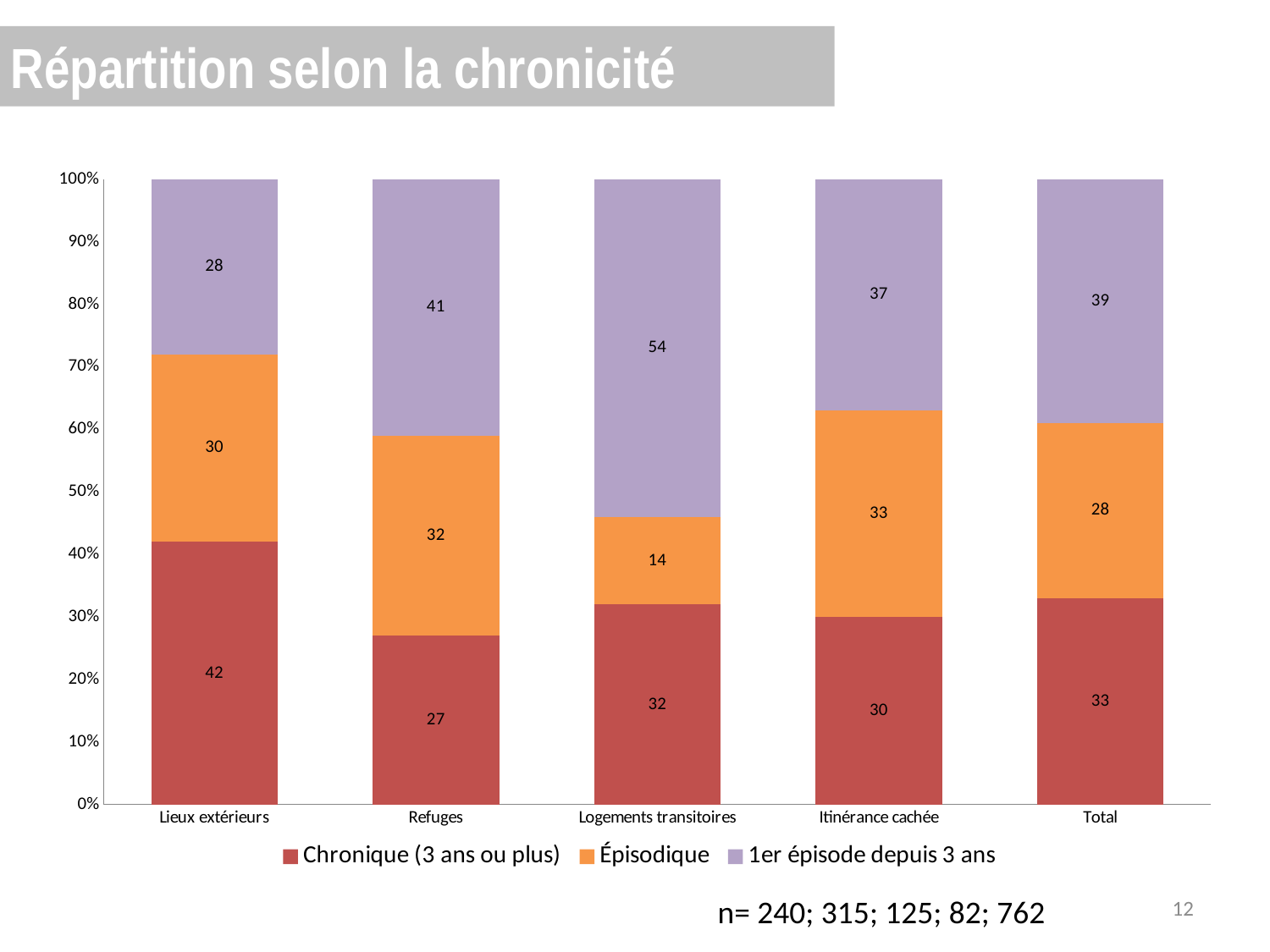
What kind of chart is shown on the slide? Stacked bar chart Which colour represents the Épisodique series? Orange Which is larger: the Épisodique value for Refuges or for Itinérance cachée? Itinérance cachée What is the value for Chronique (3 ans ou plus) in the Lieux extérieurs bar? 42 Which category has the lowest value for Épisodique? Logements transitoires What is the title of the slide? Répartition selon la chronicité Which category has the highest value for 1er épisode depuis 3 ans? Logements transitoires What is the value for Épisodique in the Total bar? 28 What is the value for 1er épisode depuis 3 ans in the Logements transitoires bar? 54 How many series does the legend list? 3 What is the difference between the Chronique (3 ans ou plus) values for Lieux extérieurs and Refuges? 15 How many categories are shown on the x axis? 5